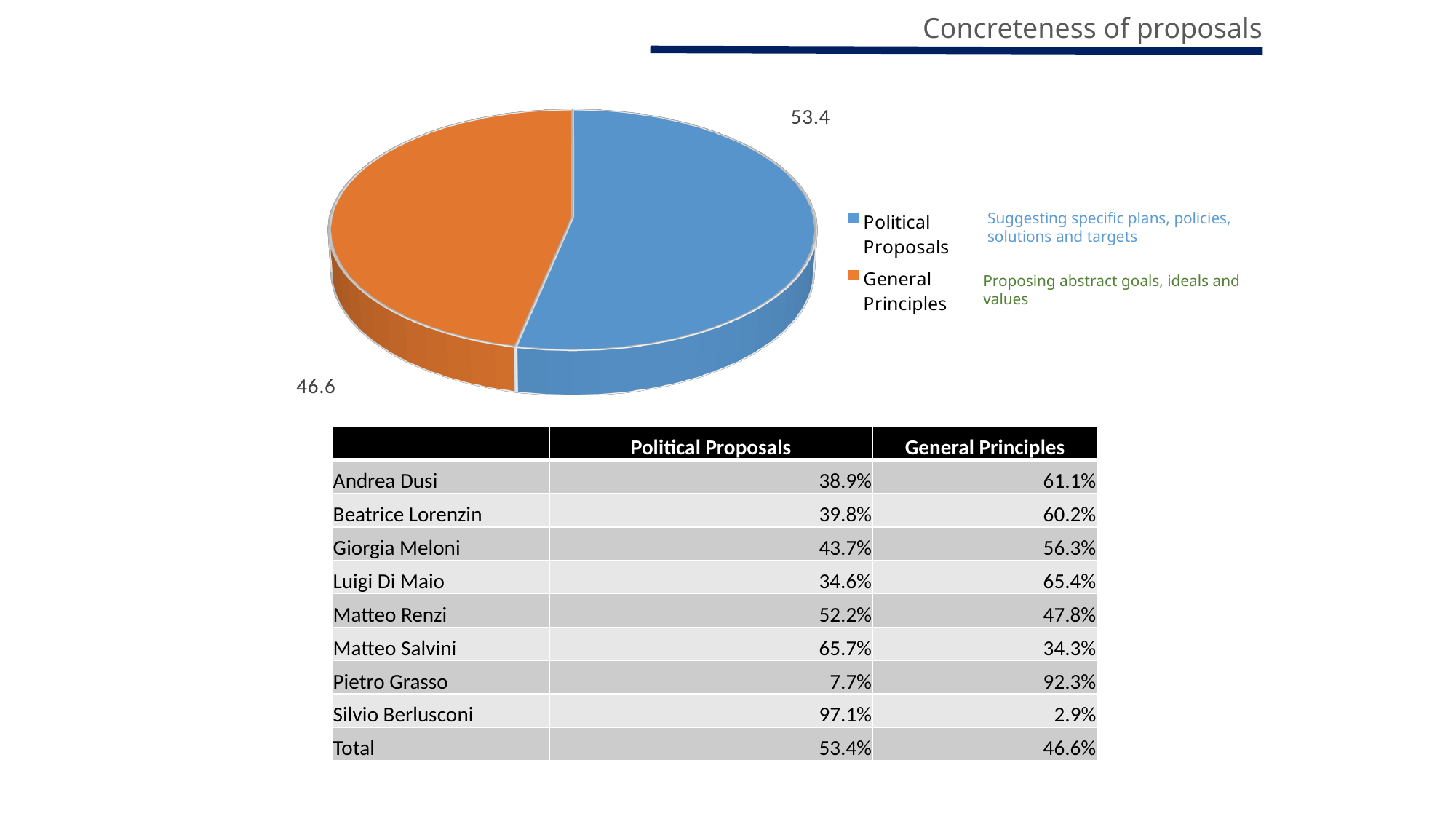
What is the value shown for the Political Proposals slice of the pie chart? 53.4 In the pie chart, which is larger: Political Proposals or General Principles? Political Proposals What share of the pie does the General Principles slice represent? 46.6 How many entries does the pie chart's legend list? 2 What type of chart is shown on the slide? pie chart Which slice of the pie chart is the smallest? General Principles What colour is the Political Proposals slice in the pie chart? blue What is the value shown for the General Principles slice of the pie chart? 46.6 What is the title shown at the top of the slide above the pie chart? Concreteness of proposals What is the difference between the Political Proposals value and the General Principles value in the pie chart? 6.8 How many slices does the pie chart have? 2 Which slice of the pie chart is the largest? Political Proposals